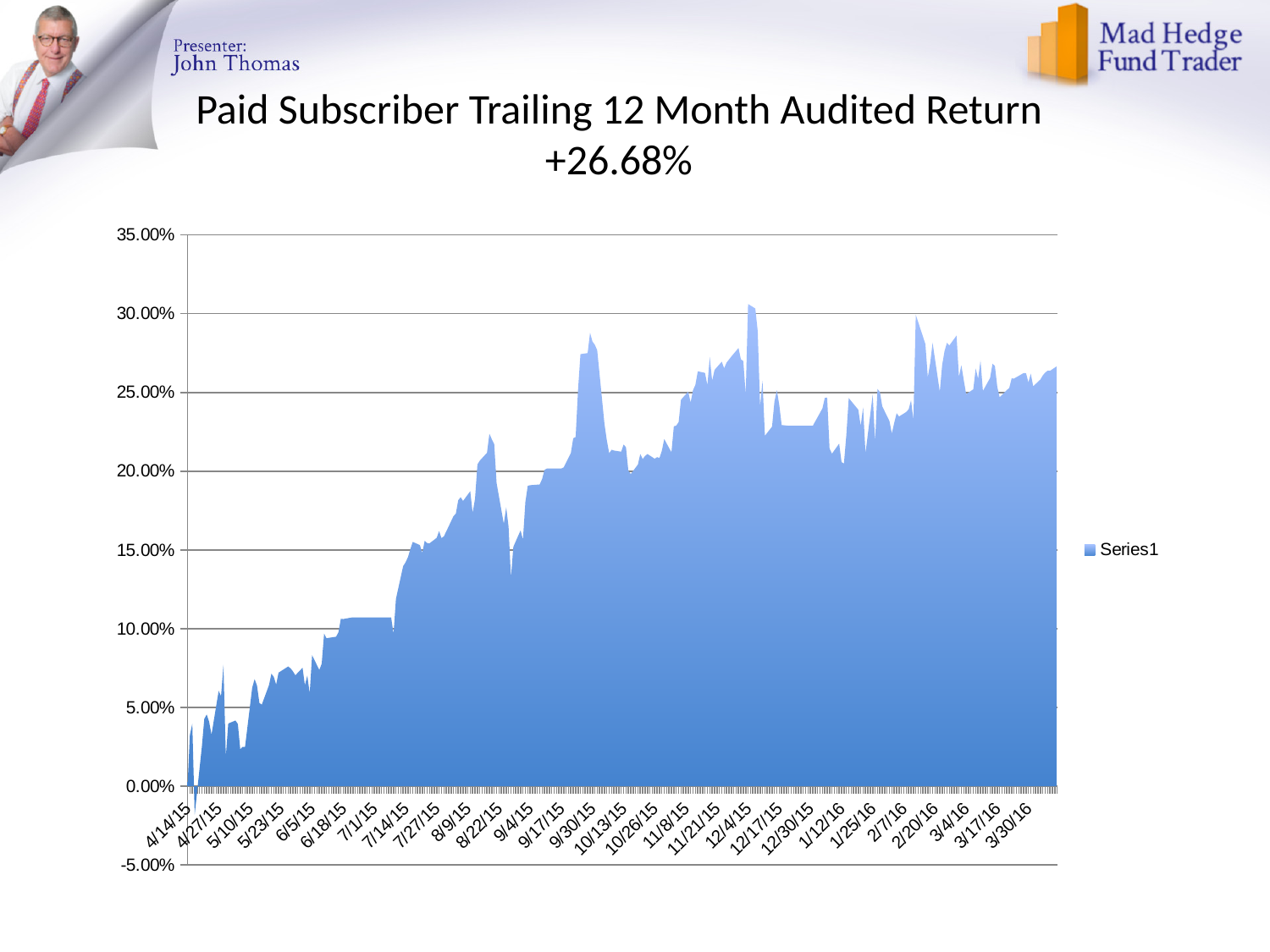
Is the value at 6/5/15 greater or less than 10.00%? less Which is larger, the value at 9/30/15 or the value at 7/1/15? 9/30/15 Is the value at 8/9/15 greater or less than 15.00%? greater Overall, do the values rise or fall from the left of the x axis to the right? Rise What kind of chart is shown on the slide? Area chart What is the name of the series shown in the legend? Series1 What is the highest value shown on the y axis? 35.00% Is the value at 5/23/15 greater or less than 10.00%? less How many series does the legend list? 1 What is the title of the chart on the slide? Paid Subscriber Trailing 12 Month Audited Return +26.68%